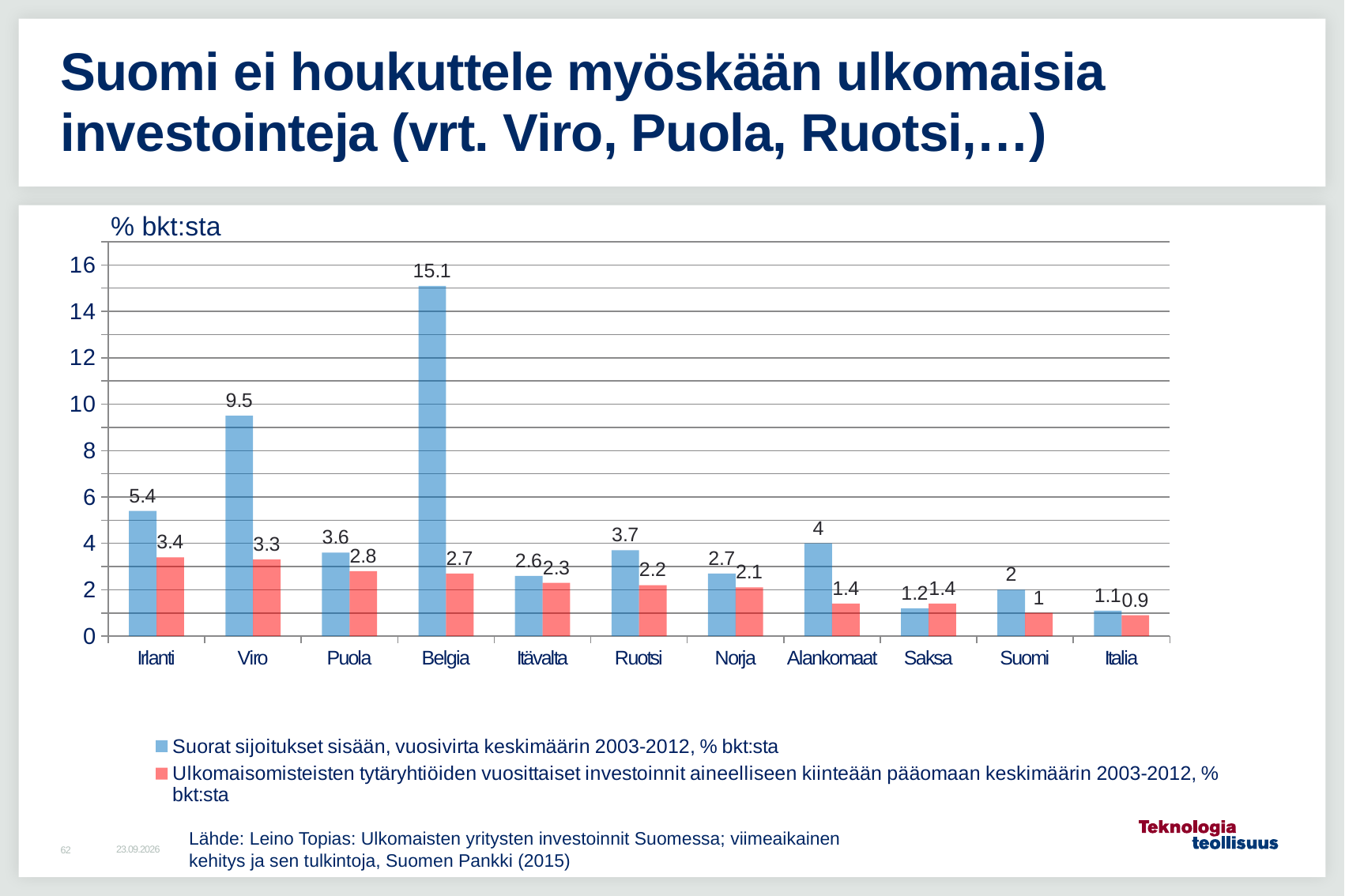
Which country has the highest value in the blue series (Suorat sijoitukset sisään)? Belgia How many countries are shown on the x axis? 11 How many series does the legend list? 2 What is the value of the blue series (Suorat sijoitukset sisään) for Belgia? 15.1 Which country has the lowest value in the red series (Ulkomaisomisteisten tytäryhtiöiden investoinnit)? Italia What kind of chart is shown on the slide? bar chart Is the blue series value for Alankomaat greater or less than 2? greater Which is larger: the blue series value for Suomi or the blue series value for Ruotsi? Ruotsi What is the value of the blue series (Suorat sijoitukset sisään) for Viro? 9.5 What is the difference between the blue series values for Belgia and Viro? 5.6 What unit label is shown above the y axis of the chart? % bkt:sta What is the value of the red series (Ulkomaisomisteisten tytäryhtiöiden investoinnit) for Suomi? 1